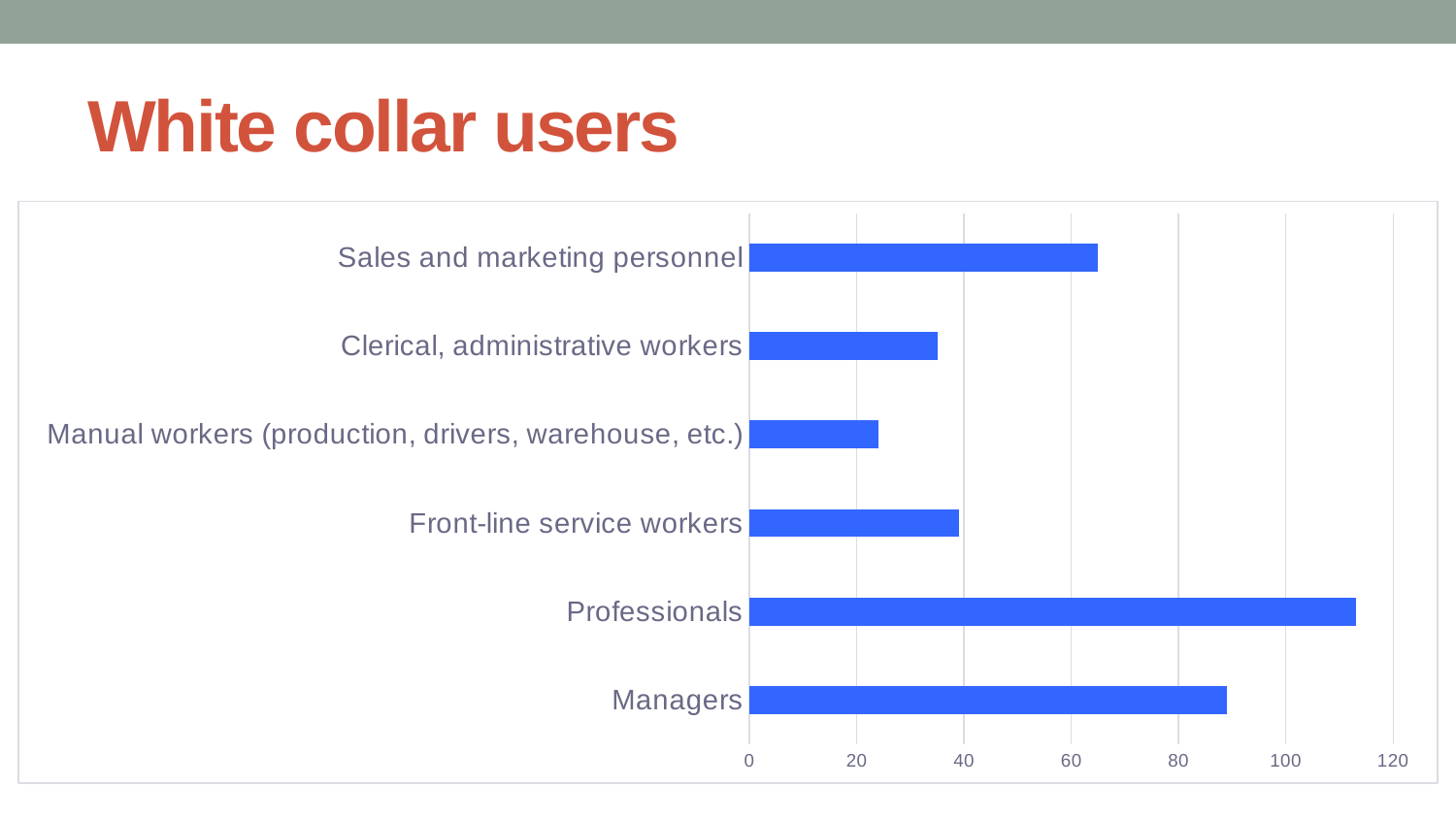
How many categories are plotted in the chart? 6 Which is larger, the value for Professionals or the value for Managers? Professionals Is the value for Professionals greater or less than 100? greater Is the value for Manual workers (production, drivers, warehouse, etc.) greater or less than 40? less What is the title of the slide containing the chart? White collar users Is the value for Managers greater or less than 80? greater Which category has the lowest value? Manual workers (production, drivers, warehouse, etc.) Which is larger, the value for Sales and marketing personnel or the value for Clerical, administrative workers? Sales and marketing personnel Which is larger, the value for Managers or the value for Sales and marketing personnel? Managers What kind of chart is shown on the slide? bar chart Which category has the highest value? Professionals